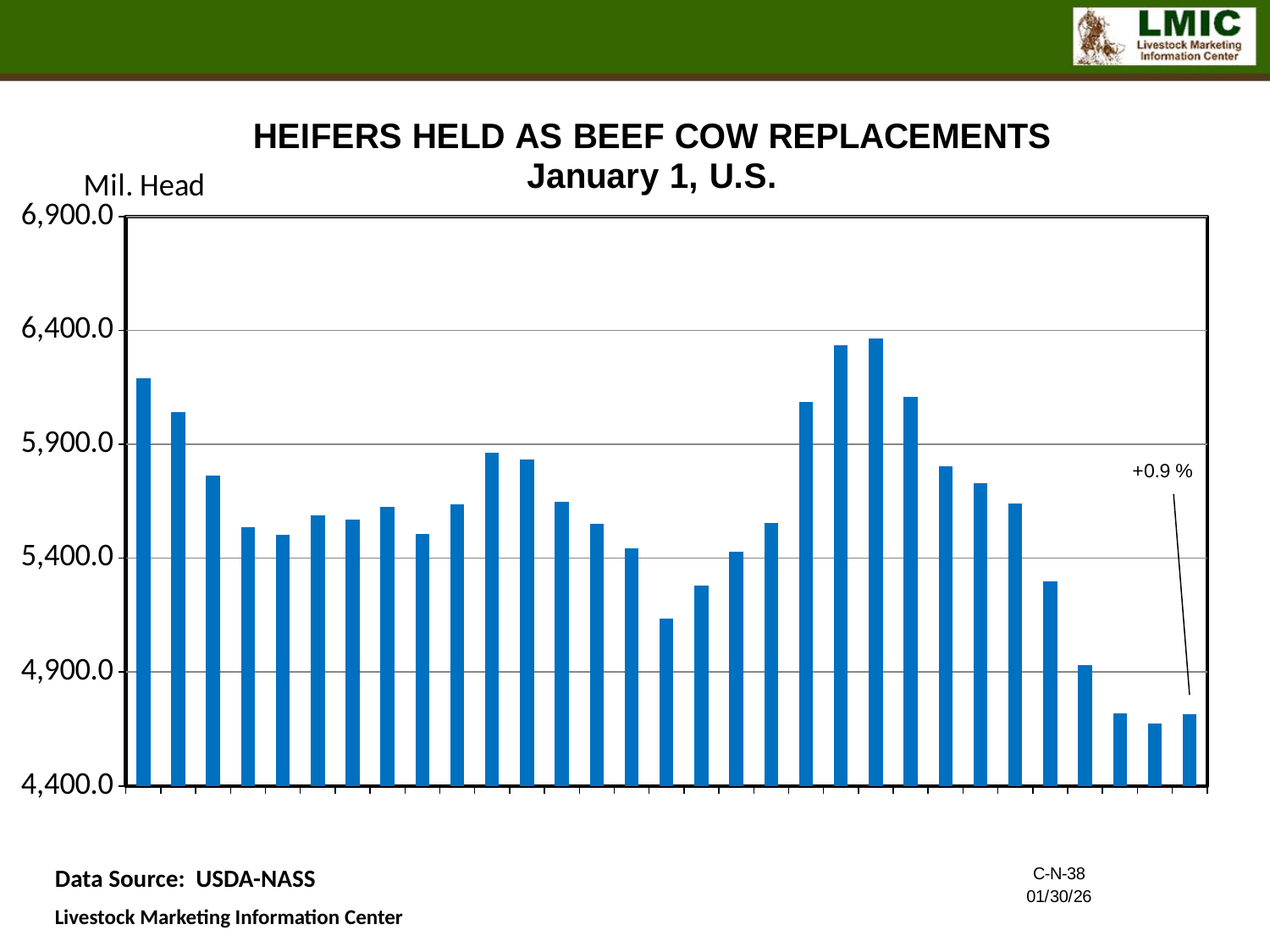
What kind of chart is shown on the slide? bar chart Is the value of the tallest bar greater or less than 6,400? less What unit is shown on the vertical axis of the chart? Mil. Head Is the value of the leftmost bar greater or less than 5,900? greater What is the title of the chart? HEIFERS HELD AS BEEF COW REPLACEMENTS January 1, U.S. Is the value of the shortest bar greater or less than 4,900? less What percentage change is annotated next to the rightmost bar? +0.9 % How many bars are plotted in the chart? 31 Which is larger, the leftmost bar or the rightmost bar? the leftmost bar Is the shortest bar located near the left end or the right end of the chart? the right end From the tallest bar to the rightmost bar, do the values rise or fall? fall